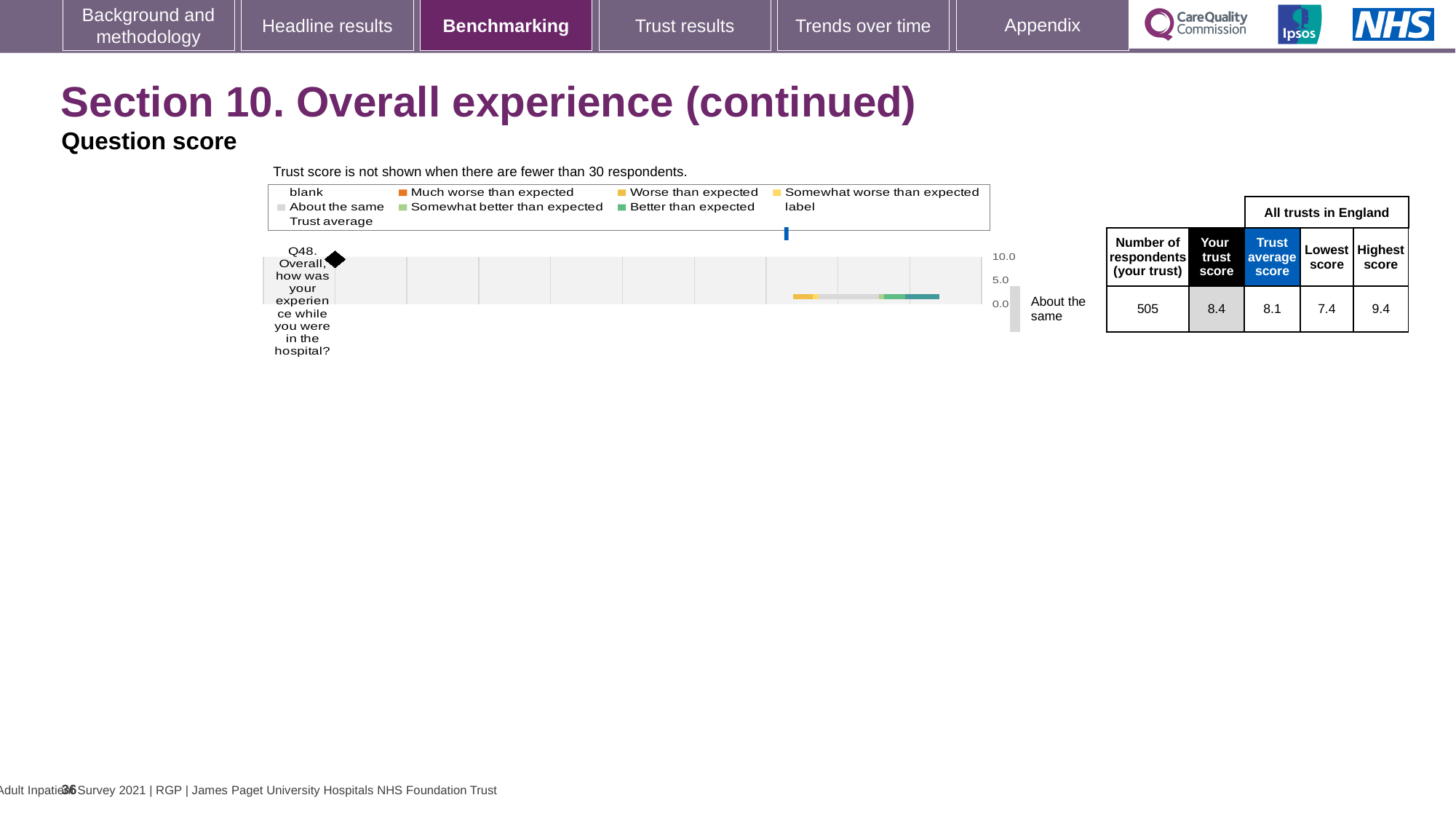
What is the highest score among all trusts in England for Q48? 9.4 How many respondents from your trust answered Q48? 505 What kind of chart is shown on the slide? bar chart What is the trust average score for Q48? 8.1 What benchmark category label is shown next to the chart for Q48? About the same What is the difference between the highest score and the lowest score for Q48? 2.0 Which question number is plotted in the chart? Q48 What is the lowest score among all trusts in England for Q48? 7.4 What is the 'Your trust score' value for Q48? 8.4 How many questions are plotted in the chart? 1 Which is larger for Q48, your trust score or the trust average score? Your trust score What is the difference between your trust score and the trust average score for Q48? 0.3